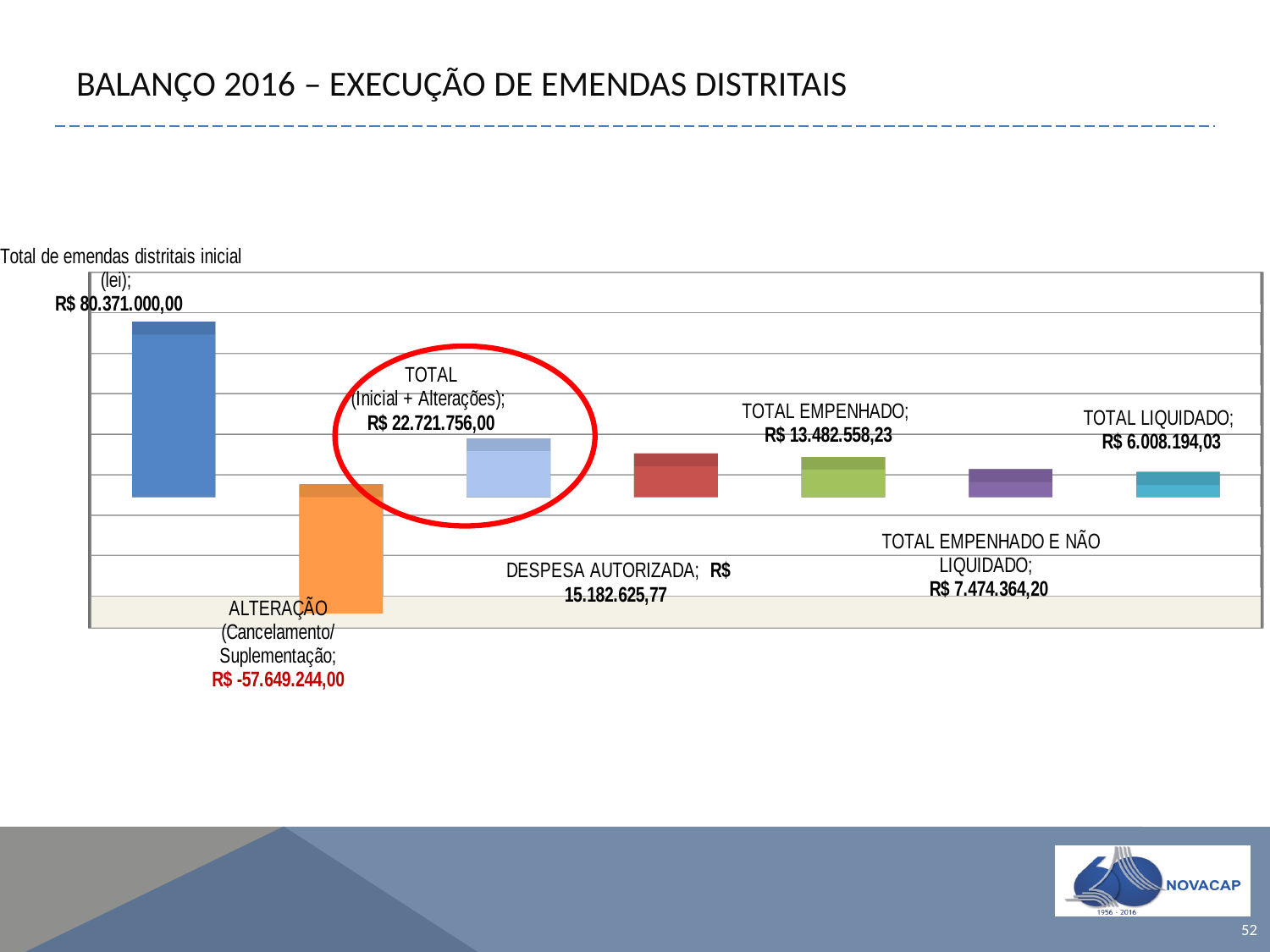
How many bars are plotted in the chart? 7 What is the value for 'TOTAL EMPENHADO'? R$ 13.482.558,23 What is the value for 'TOTAL (Inicial + Alterações)'? R$ 22.721.756,00 Which category has the lowest value? ALTERAÇÃO (Cancelamento/Suplementação) What is the difference between 'TOTAL EMPENHADO' and 'TOTAL EMPENHADO E NÃO LIQUIDADO'? R$ 6.008.194,03 What kind of chart is shown on the slide? Bar chart What is the value for 'Total de emendas distritais inicial (lei)'? R$ 80.371.000,00 Which category has the highest value? Total de emendas distritais inicial (lei) What is the value for 'ALTERAÇÃO (Cancelamento/Suplementação)'? R$ -57.649.244,00 What is the value for 'DESPESA AUTORIZADA'? R$ 15.182.625,77 Which is larger, 'DESPESA AUTORIZADA' or 'TOTAL EMPENHADO'? DESPESA AUTORIZADA What is the value for 'TOTAL LIQUIDADO'? R$ 6.008.194,03